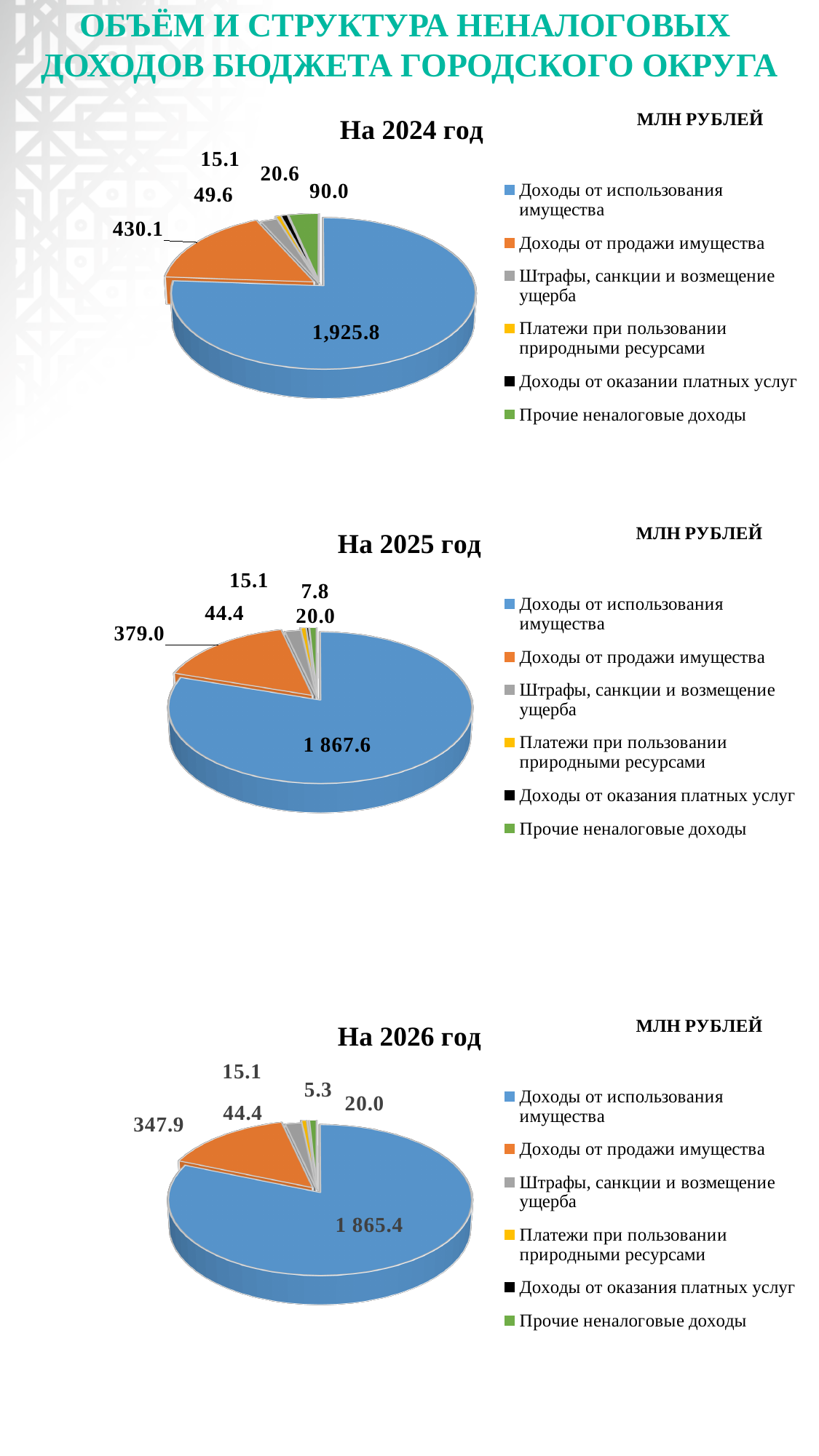
In the 'На 2024 год' chart, what is the difference between 'Доходы от использования имущества' and 'Доходы от продажи имущества'? 1,495.7 In the 'На 2024 год' chart, what is the value for 'Доходы от продажи имущества'? 430.1 What kind of chart is the 'На 2026 год' chart? Pie chart Which is larger: 'Доходы от продажи имущества' in the 'На 2024 год' chart or in the 'На 2026 год' chart? На 2024 год In the 'На 2026 год' chart, what is the value for 'Доходы от продажи имущества'? 347.9 In the 'На 2025 год' chart, what is the value for 'Доходы от использования имущества'? 1 867.6 What unit is stated above the legend of each chart? МЛН РУБЛЕЙ How many entries does the legend of the 'На 2025 год' chart list? 6 In the 'На 2026 год' chart, what is the value for 'Доходы от использования имущества'? 1 865.4 In the 'На 2025 год' chart, what is the value for 'Доходы от продажи имущества'? 379.0 In the 'На 2024 год' chart, what is the value for 'Доходы от использования имущества'? 1,925.8 In the 'На 2024 год' chart, which category has the largest slice? Доходы от использования имущества